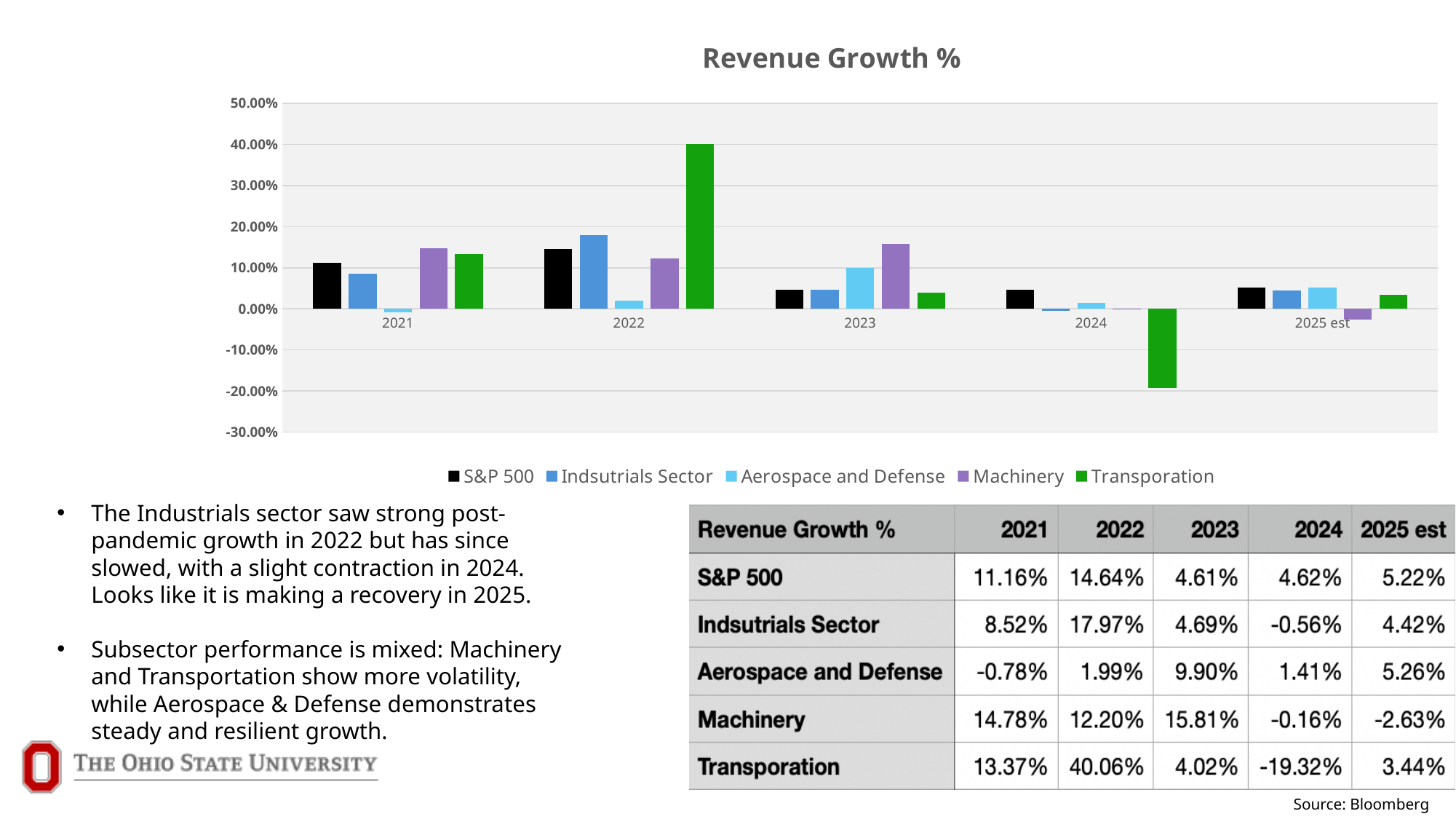
What is the title of the chart? Revenue Growth % What is the difference between the Industrials Sector and S&P 500 revenue growth in 2022? 3.33% How many series does the chart legend list? 5 What is the revenue growth for the S&P 500 in 2021? 11.16% In 2023, which is larger: Machinery or Aerospace and Defense revenue growth? Machinery Is the value for Transportation in 2022 greater or less than 30.00%? greater What is the revenue growth for Machinery in 2025 est? -2.63% What type of chart is shown on the slide? bar chart How many year categories are shown on the x axis of the chart? 5 Which series has the lowest revenue growth in 2024? Transporation What is the revenue growth for Transportation in 2022? 40.06% Which series has the highest revenue growth in 2022? Transporation